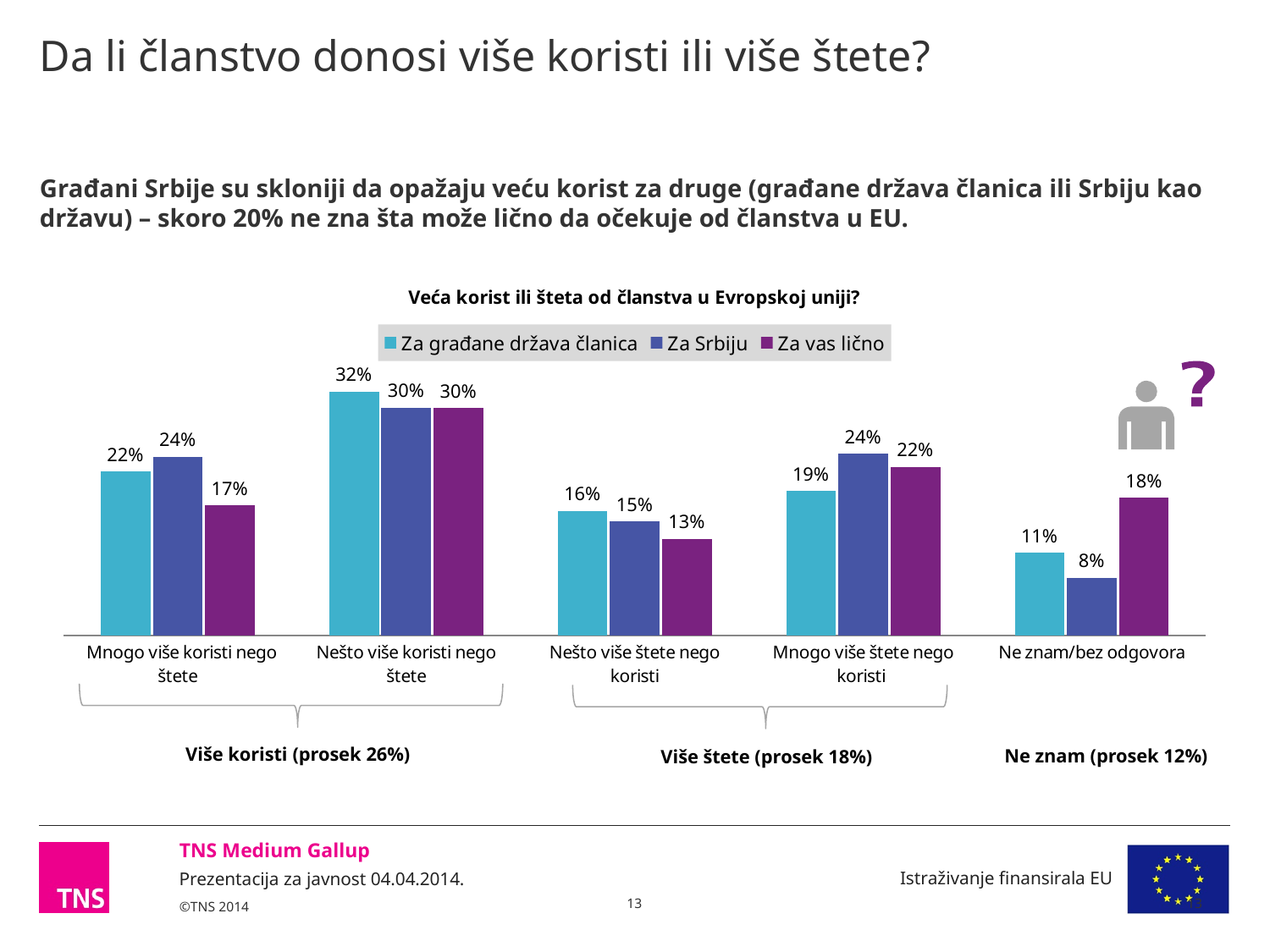
Which series is shown in the darkest purple colour in the legend? Za vas lično What is the difference between 'Za Srbiju' and 'Za vas lično' in the 'Mnogo više koristi nego štete' category? 7% Which category has the lowest value for the 'Za Srbiju' series? Ne znam/bez odgovora What is the title of the chart? Veća korist ili šteta od članstva u Evropskoj uniji? Which category has the highest value for the 'Za građane država članica' series? Nešto više koristi nego štete What is the value for 'Za građane država članica' in the 'Mnogo više štete nego koristi' category? 19% In the 'Nešto više štete nego koristi' category, which is larger: 'Za građane država članica' or 'Za vas lično'? Za građane država članica How many categories are shown on the x axis? 5 What kind of chart is shown on the slide? Bar chart What is the value for 'Za vas lično' in the 'Ne znam/bez odgovora' category? 18% How many series does the legend list? 3 What is the value for 'Za Srbiju' in the 'Nešto više koristi nego štete' category? 30%